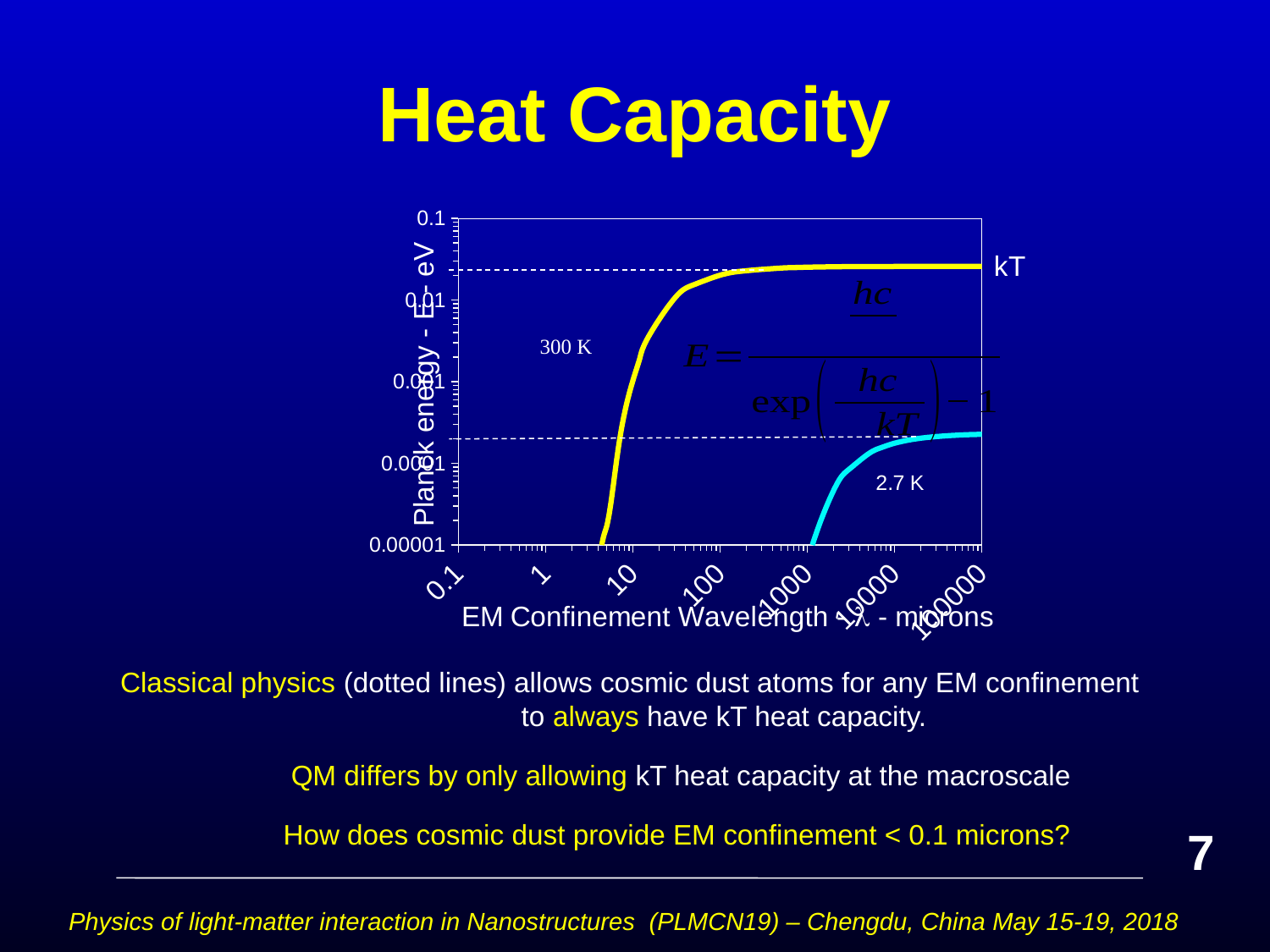
What is the highest wavelength tick shown on the x axis? 100000 Is the plateau value of the 300 K curve greater or less than 0.1 eV? less Is the plateau value of the 2.7 K curve greater or less than 0.0001 eV? greater What is the label of the y axis of the chart? Planck energy - E - eV Which curve reaches its plateau at a shorter wavelength, 300 K or 2.7 K? 300 K Do the plotted curves rise or fall as the EM confinement wavelength increases? rise Which temperature curve reaches higher Planck energy values, 300 K or 2.7 K? 300 K How many temperature curves are plotted on the chart? 2 Is the plateau value of the 300 K curve greater or less than 0.01 eV? greater What is the label of the x axis of the chart? EM Confinement Wavelength λ - microns What kind of chart is shown on the slide? line chart